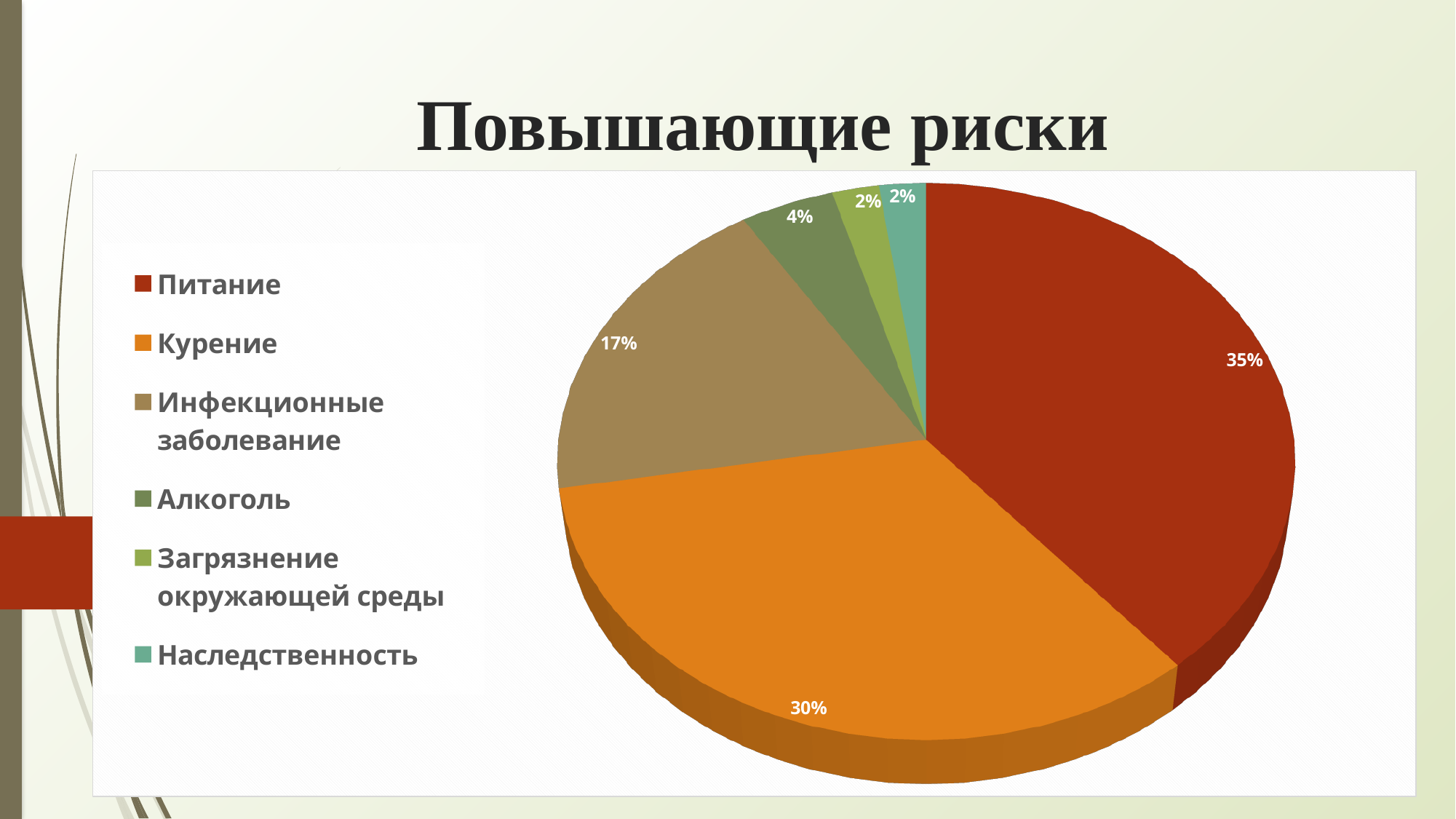
What colour is the slice for Курение? Orange What is the difference between the shares of Питание and Курение? 5% What share of the pie does Инфекционные заболевание have? 17% What share of the pie does Алкоголь have? 4% What share of the pie does Курение have? 30% How many categories does the legend list? 6 What kind of chart is shown on the slide? Pie chart What is the title of the slide? Повышающие риски Which category has the largest slice of the pie? Питание Which is larger, the share for Инфекционные заболевание or the share for Алкоголь? Инфекционные заболевание